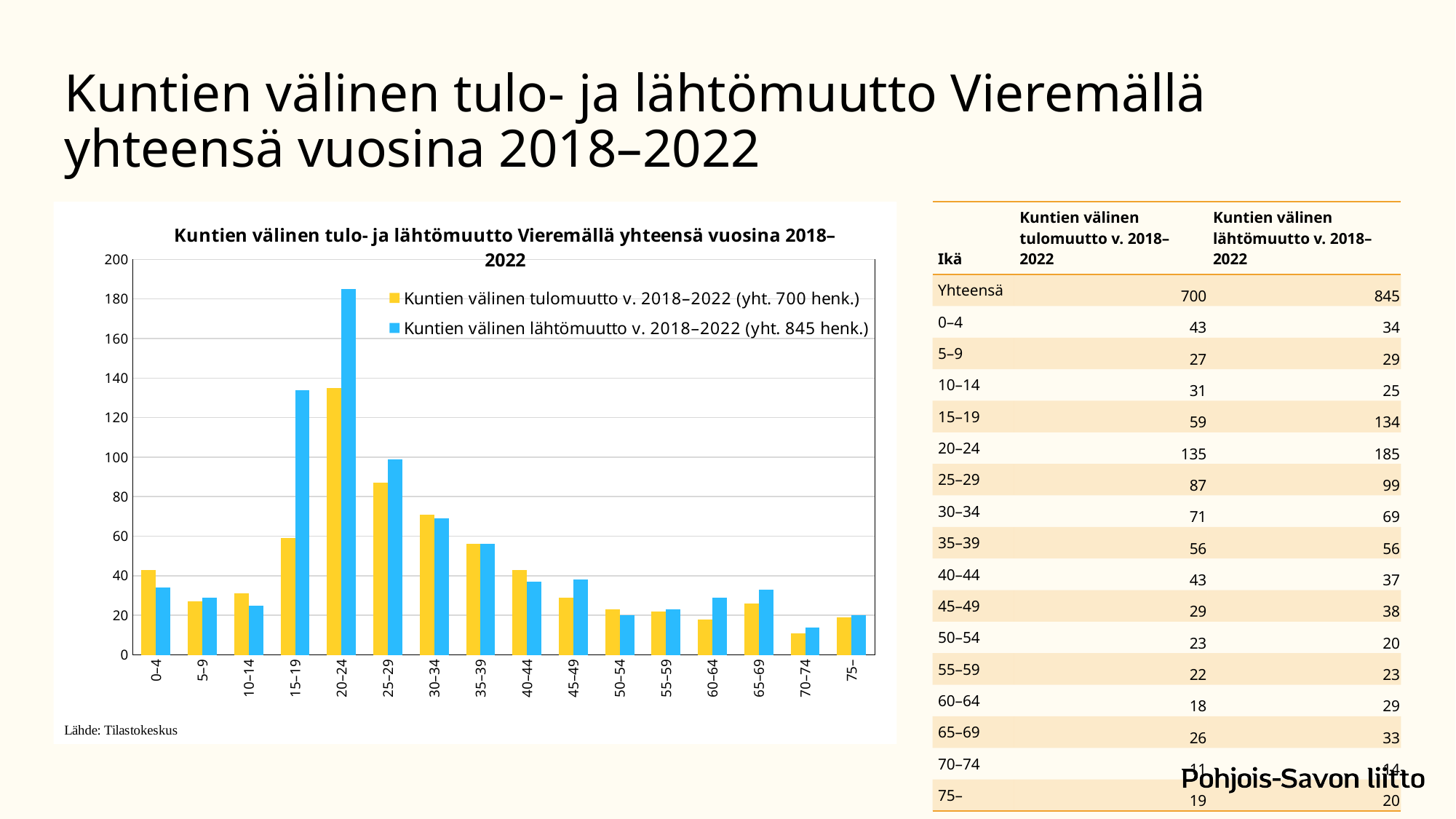
Is the value for Kuntien välinen tulomuutto in the 15–19 age group greater or less than 80? less How many series does the chart's legend list? 2 According to the legend, what is the total number of people (yht.) for Kuntien välinen tulomuutto v. 2018–2022? 700 henk. Which age group has the lowest value for Kuntien välinen tulomuutto v. 2018–2022? 70–74 For the 0–4 age group, which is larger: tulomuutto or lähtömuutto? tulomuutto For the 20–24 age group, what is the difference between lähtömuutto and tulomuutto? 50 Is the value for Kuntien välinen lähtömuutto in the 20–24 age group greater or less than 160? greater How many age groups are shown on the x axis of the chart? 16 What is the value of Kuntien välinen tulomuutto v. 2018–2022 for the 20–24 age group? 135 Which age group has the highest value for Kuntien välinen lähtömuutto v. 2018–2022? 20–24 What is the value of Kuntien välinen lähtömuutto v. 2018–2022 for the 15–19 age group? 134 What kind of chart is shown on the slide? bar chart